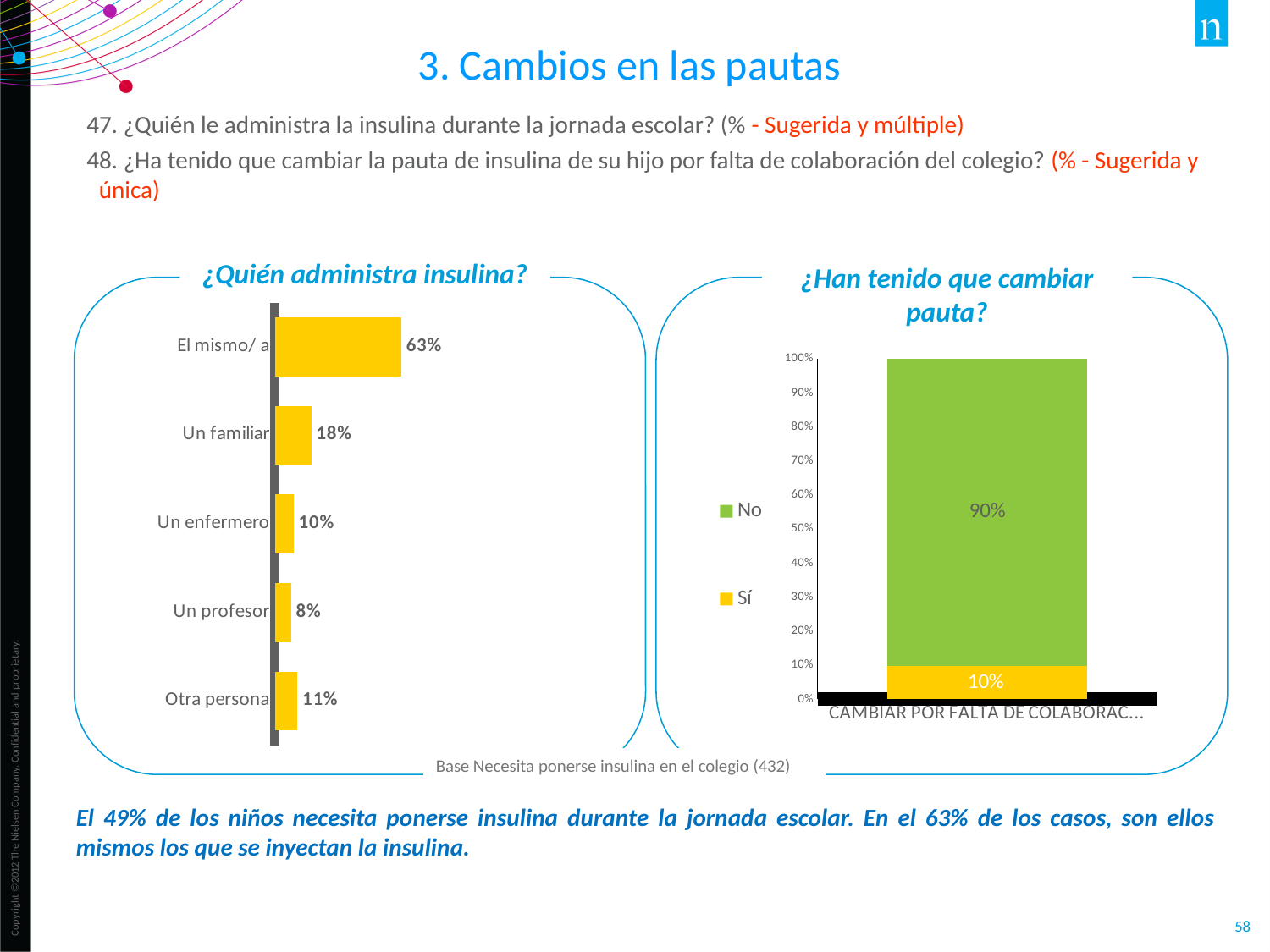
How many series does the legend of the '¿Han tenido que cambiar pauta?' chart list? 2 In the '¿Han tenido que cambiar pauta?' chart, what is the total of the stacked bar? 100% In the '¿Quién administra insulina?' chart, which category has the highest value? El mismo/ a In the '¿Quién administra insulina?' chart, what is the value for 'Un familiar'? 18% What kind of chart is the '¿Quién administra insulina?' chart? Bar chart In the '¿Quién administra insulina?' chart, what is the value for 'El mismo/ a'? 63% In the '¿Han tenido que cambiar pauta?' chart, what is the value for 'No'? 90% In the '¿Quién administra insulina?' chart, what is the difference between 'El mismo/ a' and 'Un familiar'? 45% In the '¿Quién administra insulina?' chart, which is larger: 'Un enfermero' or 'Otra persona'? Otra persona How many categories are shown in the '¿Quién administra insulina?' chart? 5 In the '¿Quién administra insulina?' chart, which category has the lowest value? Un profesor In the '¿Han tenido que cambiar pauta?' chart, what is the value for 'Sí'? 10%